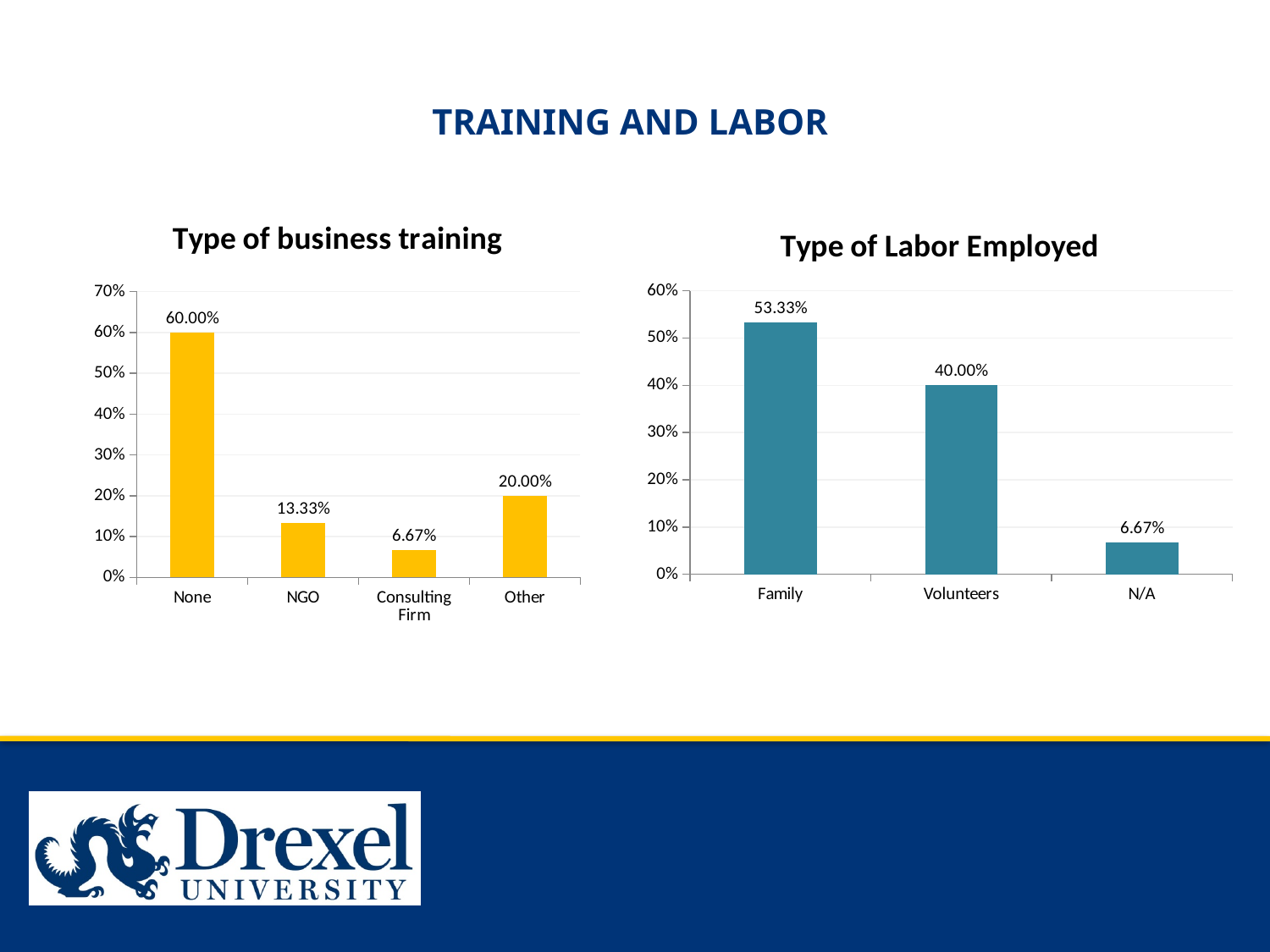
What kind of chart is the 'Type of Labor Employed' chart? Bar chart In the 'Type of business training' chart, what is the value for None? 60.00% In the 'Type of Labor Employed' chart, what is the value for Volunteers? 40.00% What is the title of the chart on the left side of the slide? Type of business training In the 'Type of business training' chart, which is larger, NGO or Other? Other In the 'Type of Labor Employed' chart, what is the difference between the values for Family and Volunteers? 13.33% In the 'Type of business training' chart, which category has the lowest value? Consulting Firm In the 'Type of Labor Employed' chart, how many categories are shown? 3 In the 'Type of business training' chart, what is the value for Consulting Firm? 6.67% In the 'Type of Labor Employed' chart, which category has the highest value? Family In the 'Type of business training' chart, how many categories are shown? 4 In the 'Type of business training' chart, what is the difference between the values for None and Other? 40.00%